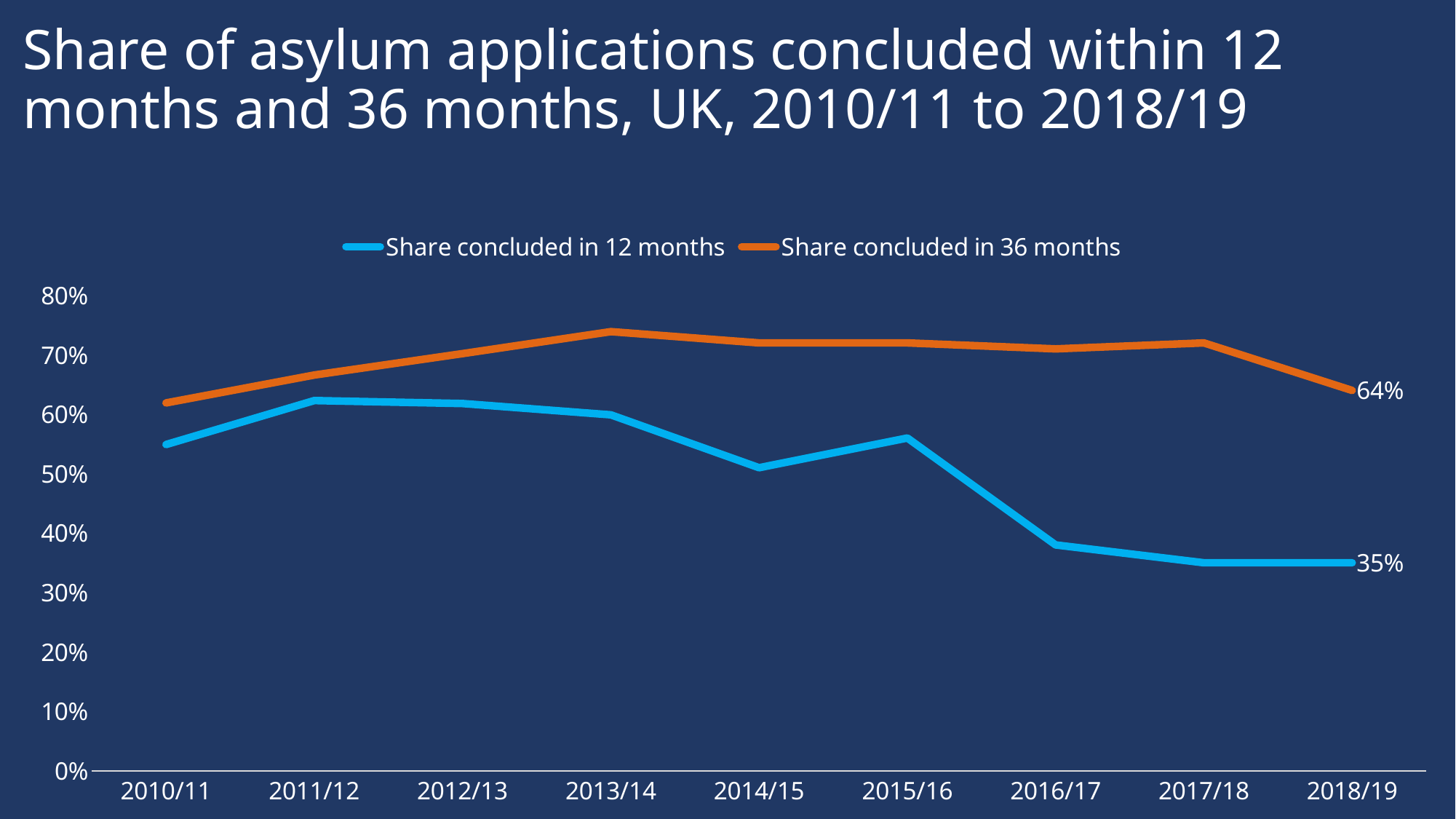
What is the share of asylum applications concluded in 12 months in 2018/19? 35% Is the share concluded in 12 months in 2016/17 greater or less than 40%? less In which year is the share concluded in 12 months at its lowest? 2017/18 and 2018/19 (tied at 35%) How many years are shown on the x axis? 9 What is the share of asylum applications concluded in 36 months in 2018/19? 64% What kind of chart is shown on the slide? Line chart Which series has the higher value in 2018/19, share concluded in 12 months or share concluded in 36 months? Share concluded in 36 months What is the difference between the share concluded in 36 months and the share concluded in 12 months in 2018/19? 29 percentage points How many series does the legend list? 2 In which year is the share concluded in 36 months at its lowest? 2010/11 Is the share concluded in 36 months in 2013/14 greater or less than 70%? greater Is the share concluded in 12 months in 2011/12 greater or less than 60%? greater